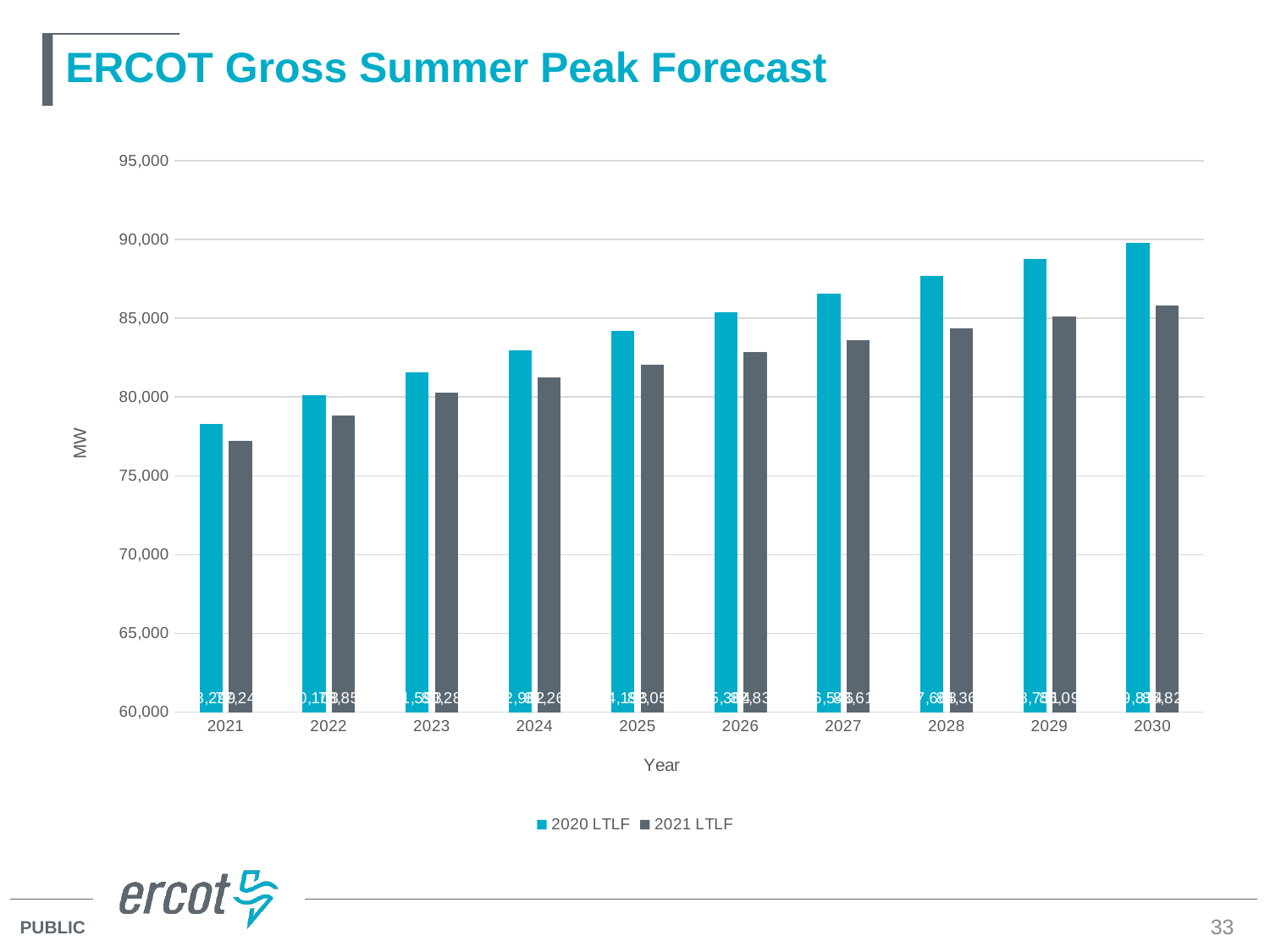
Is the 2020 LTLF value for 2021 greater or less than 80,000? less Do the 2021 LTLF values rise or fall from 2021 to 2030? rise Is the 2021 LTLF value for 2021 greater or less than 80,000? less What is the title of the chart? ERCOT Gross Summer Peak Forecast Is the 2020 LTLF value for 2030 greater or less than 85,000? greater Which year has the lowest 2021 LTLF value? 2021 How many series does the legend list? 2 What is the label on the y axis? MW What kind of chart is shown on the slide? bar chart Which year has the highest 2020 LTLF value? 2030 How many years are shown on the x axis? 10 In 2030, which series has the larger value, 2020 LTLF or 2021 LTLF? 2020 LTLF